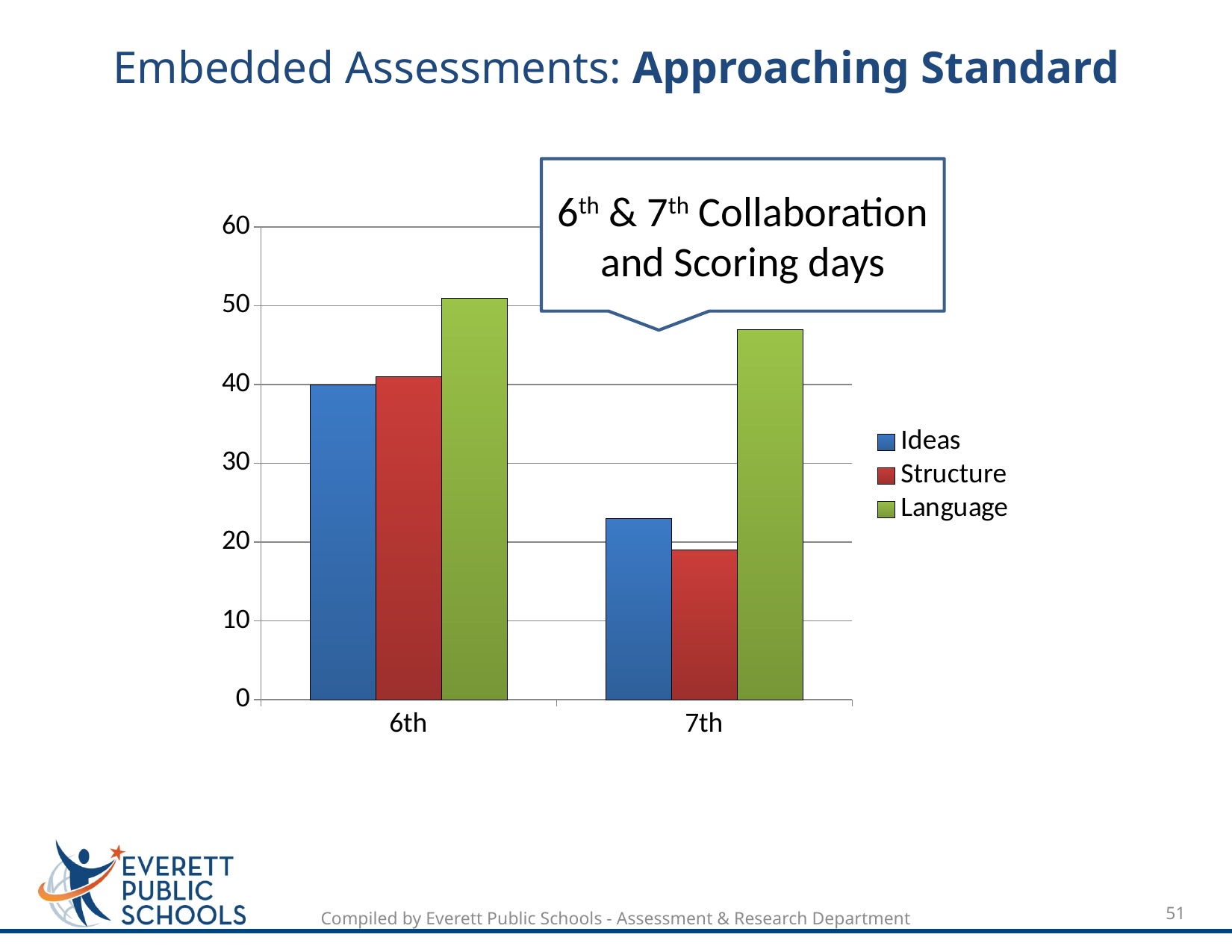
Which series has the highest value for 7th grade? Language Which is larger, the Ideas value for 6th grade or the Ideas value for 7th grade? 6th grade Is the Language value for 6th grade greater or less than 50? greater Which series has the lowest value for 7th grade? Structure How many series does the legend list? 3 How many grade categories are shown on the x axis? 2 Is the Structure value for 7th grade greater or less than 20? less Do the Structure values rise or fall from 6th to 7th grade? fall Which series has the highest value for 6th grade? Language Which colour represents the Language series in the legend? green What kind of chart is shown on the slide? bar chart Is the Language value for 7th grade greater or less than 50? less